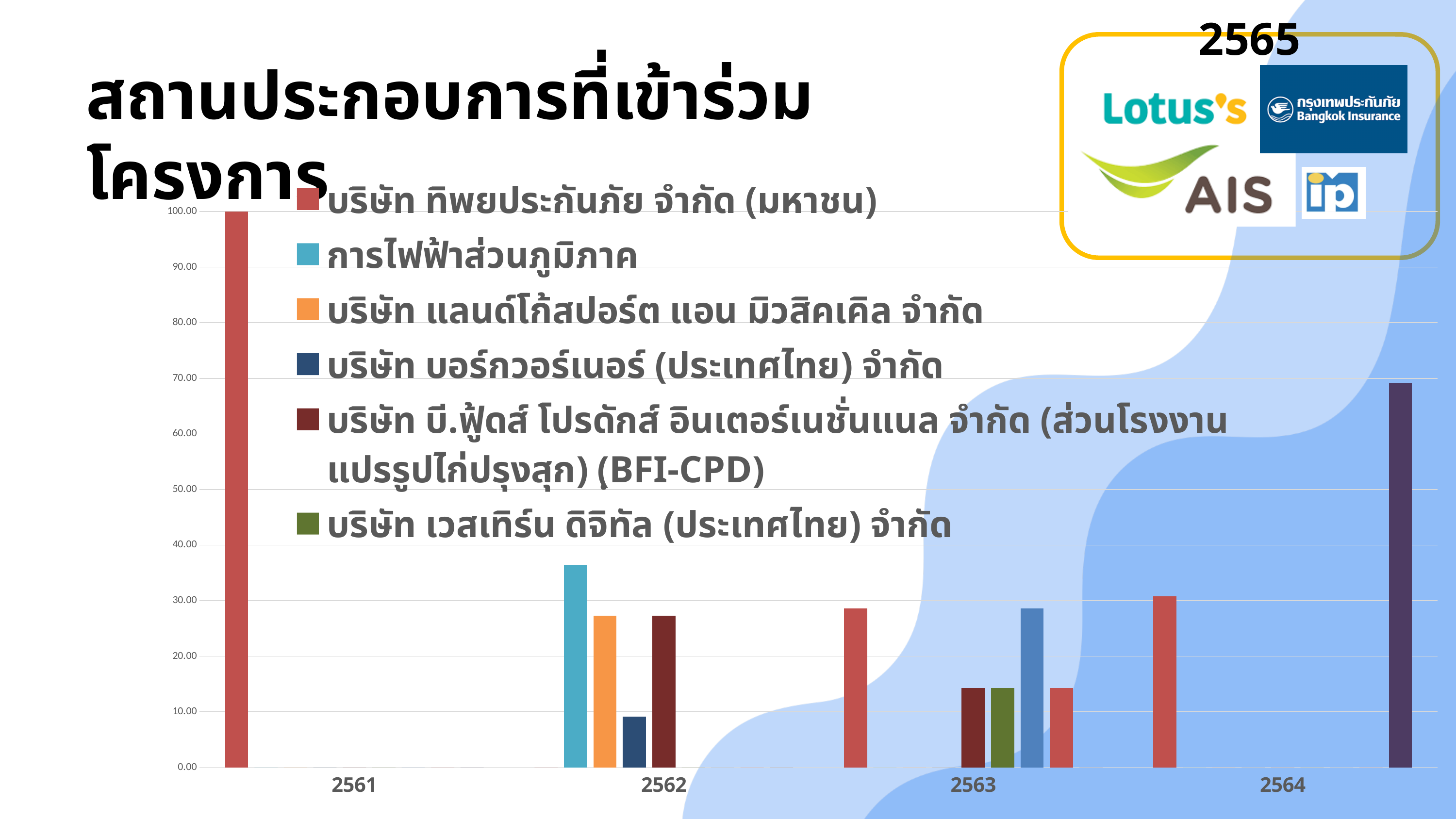
What year is written above the logo box in the top-right corner of the slide? 2565 Is the value for บริษัท เวสเทิร์น ดิจิทัล (ประเทศไทย) จำกัด in 2563 greater or less than 20? less Is the value for บริษัท ทิพยประกันภัย จำกัด (มหาชน) in 2561 greater or less than 90? greater Is the tallest bar in 2564 greater or less than 60? greater In 2562, which is larger: the bar for การไฟฟ้าส่วนภูมิภาค or the bar for บริษัท แลนด์โก้สปอร์ต แอน มิวสิคเคิล จำกัด? การไฟฟ้าส่วนภูมิภาค Which year on the x axis contains the tallest bar in the chart? 2561 How many year categories are shown on the x axis of the chart? 4 How many series does the chart legend list? 6 What kind of chart is shown on the slide? bar chart What colour is the legend marker for บริษัท ทิพยประกันภัย จำกัด (มหาชน)? red